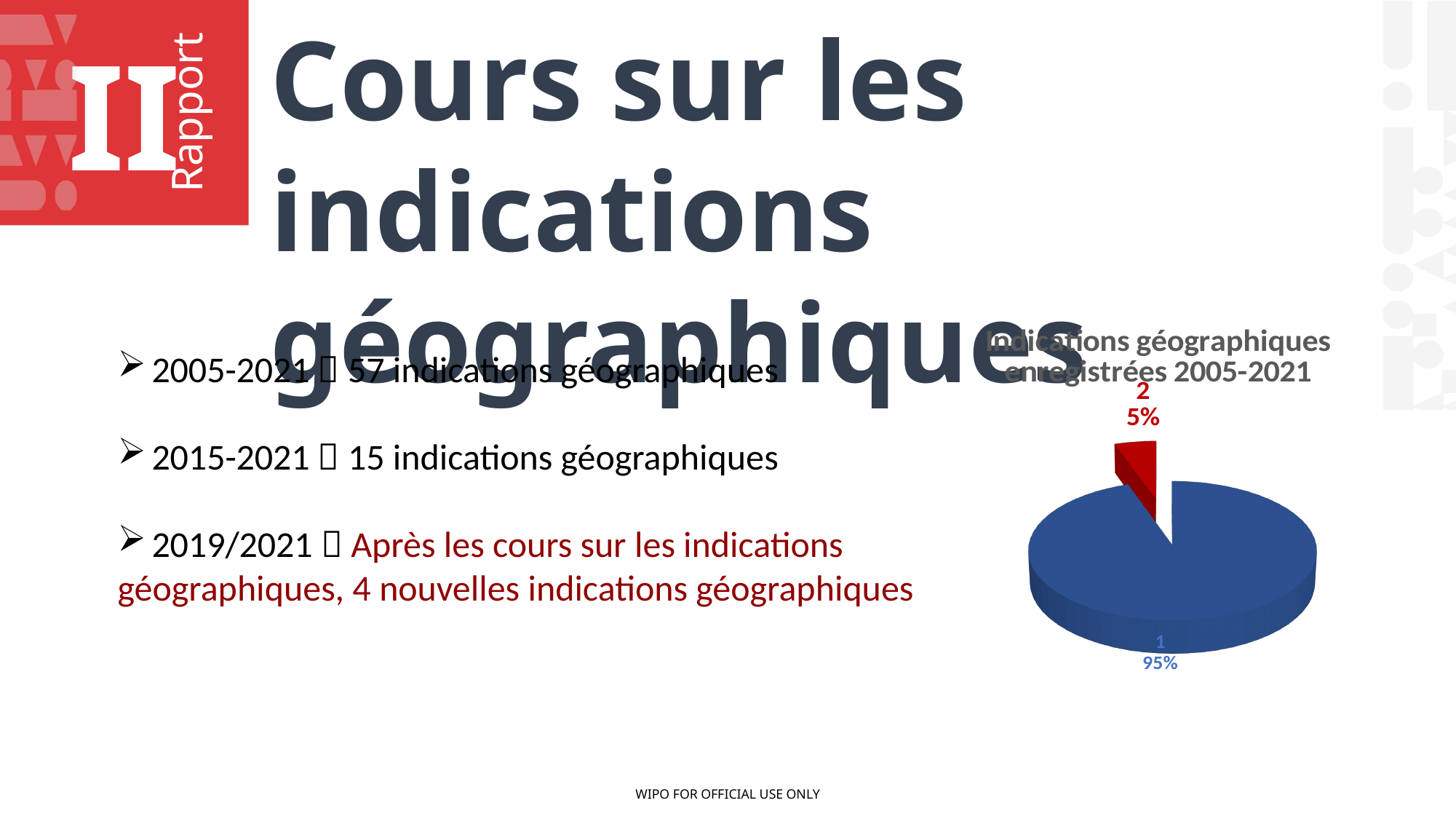
Is the share for slice 1 greater or less than 50%? greater Which slice of the pie chart is the smallest? 2 How many slices does the pie chart have? 2 What share of the pie does slice 2 represent? 5% Is the share for slice 2 greater or less than 10%? less What kind of chart is shown on the slide? pie chart Which slice is larger, slice 1 or slice 2? 1 What is the difference in percentage points between slice 1 and slice 2? 90 What is the title of the pie chart? Indications géographiques enregistrées 2005-2021 What colour is the slice labelled 2 in the pie chart? red Which slice of the pie chart is the largest? 1 What share of the pie does slice 1 represent? 95%